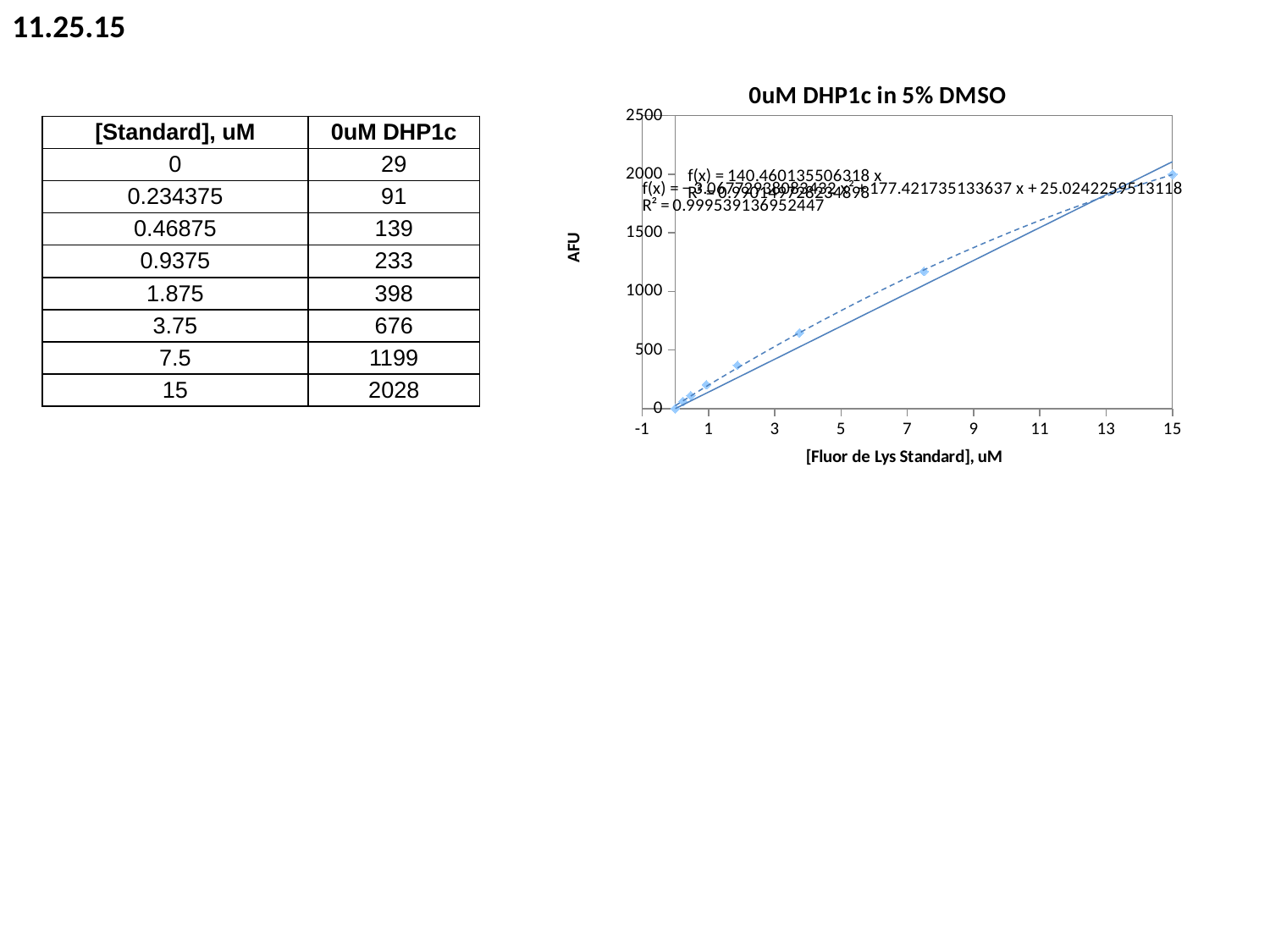
According to the table on the slide, what is the 0uM DHP1c value at a standard concentration of 3.75 uM? 676 Which has the larger AFU value, the point at 7.5 uM or the point at 3.75 uM? 7.5 uM According to the table on the slide, what is the difference between the 0uM DHP1c values at 15 uM and 7.5 uM? 829 What is the label on the y axis of the chart? AFU Is the AFU value at 3.75 uM greater or less than 500? greater Is the AFU value at 1.875 uM greater or less than 500? less What kind of chart is shown on the slide? scatter chart How many data points are plotted in the chart? 8 Is the AFU value at 7.5 uM greater or less than 1000? greater Do the AFU values rise or fall as the standard concentration increases along the x axis? rise What is the title of the chart? 0uM DHP1c in 5% DMSO At which standard concentration is the AFU value highest? 15